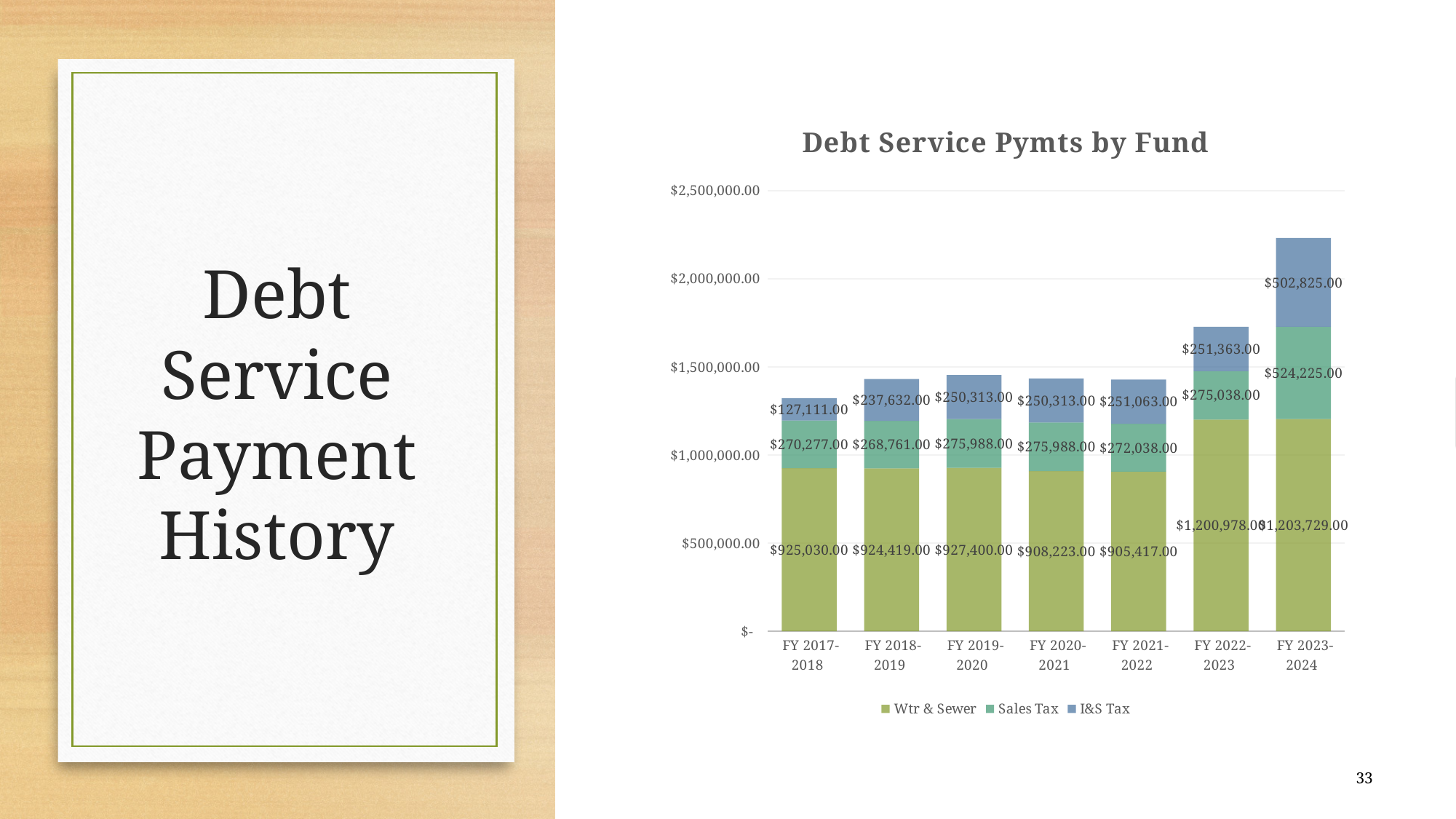
Which is larger, the I&S Tax value for FY 2018-2019 or for FY 2017-2018? FY 2018-2019 What is the Sales Tax value for FY 2021-2022? $272,038.00 How many fiscal years are shown on the x axis? 7 Which fiscal year has the highest Wtr & Sewer value? FY 2023-2024 Is the total stacked bar for FY 2023-2024 greater or less than $2,000,000.00? greater What kind of chart is shown on the slide? Stacked bar chart How many series does the legend list? 3 What is the Wtr & Sewer value for FY 2017-2018? $925,030.00 Which fiscal year has the lowest I&S Tax value? FY 2017-2018 What is the difference between the Sales Tax value for FY 2023-2024 and FY 2022-2023? $249,187.00 What is the total of the stacked bar for FY 2017-2018? $1,322,418.00 What is the I&S Tax value for FY 2023-2024? $502,825.00